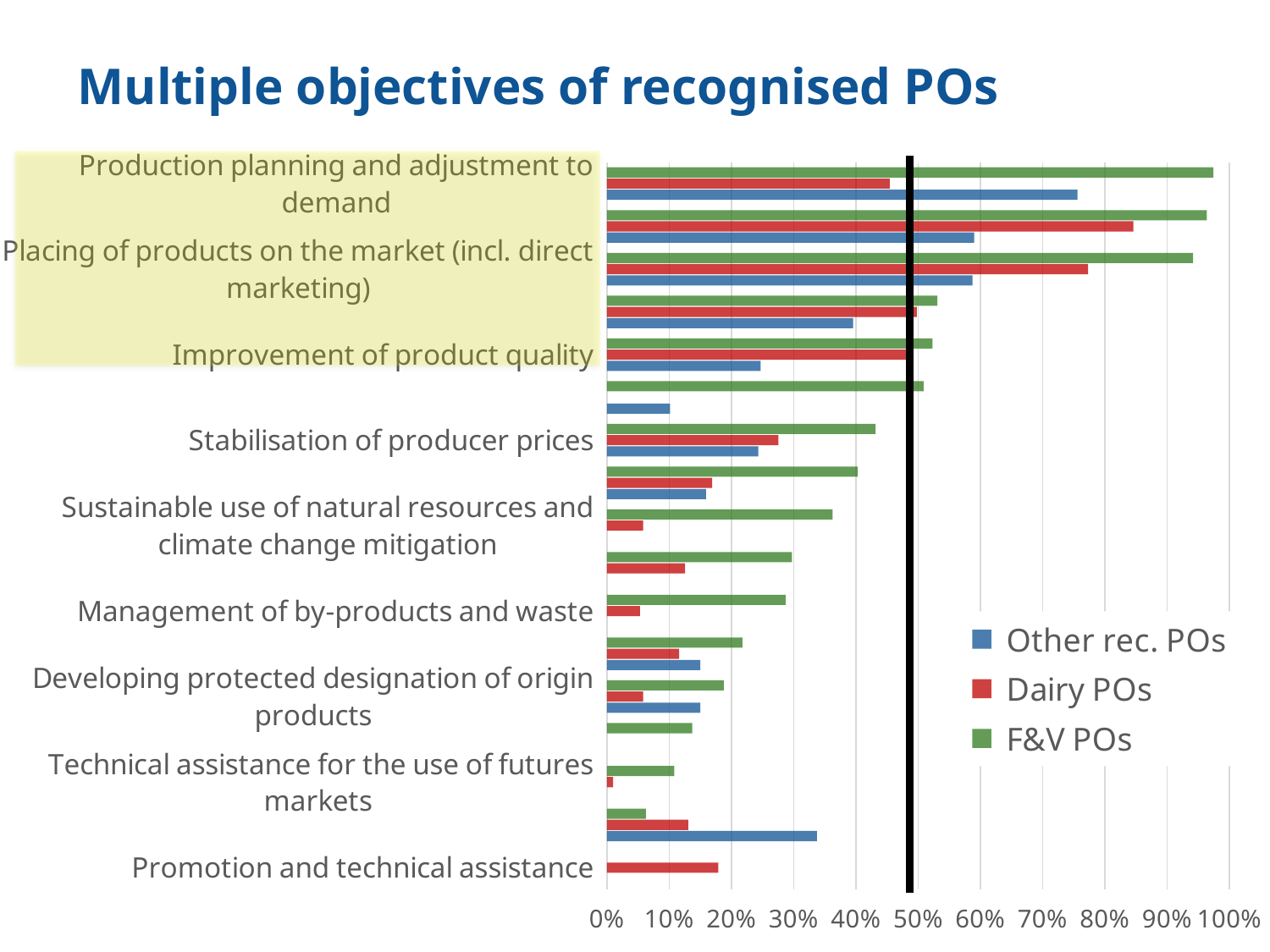
What kind of chart is shown on the slide? bar chart How many series does the legend list? 3 Is the value for Dairy POs on 'Production planning and adjustment to demand' greater or less than 60%? less Is the value for Dairy POs on 'Promotion and technical assistance' greater or less than 30%? less Is the value for F&V POs on 'Production planning and adjustment to demand' greater or less than 90%? greater What is the title of the chart? Multiple objectives of recognised POs What is the highest value shown on the horizontal axis? 100% For 'Production planning and adjustment to demand', which series has the larger value: F&V POs or Dairy POs? F&V POs What are the three series named in the legend? Other rec. POs, Dairy POs, F&V POs For 'Production planning and adjustment to demand', which series has the larger value: Other rec. POs or Dairy POs? Other rec. POs